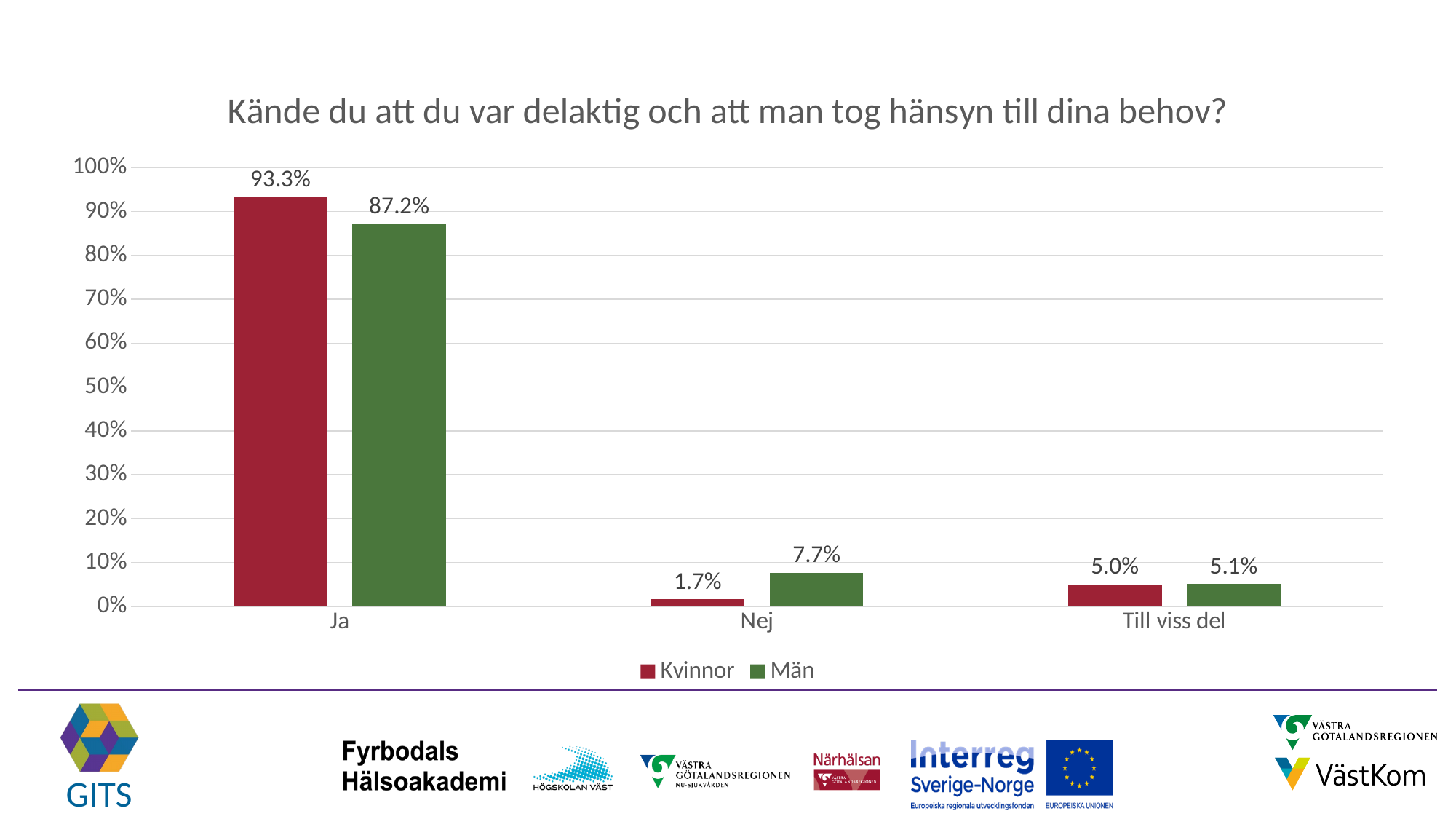
What is the value for Kvinnor in the Till viss del category? 5.0% What is the value for Män in the Nej category? 7.7% How many categories are shown on the x axis? 3 What kind of chart is shown on the slide? Bar chart What is the value for Kvinnor in the Ja category? 93.3% What is the difference between the Kvinnor and Män values in the Ja category? 6.1% Is the value for Män in the Ja category greater or less than 80%? greater In the Nej category, which series has the larger value, Kvinnor or Män? Män Which category has the lowest value for Kvinnor? Nej What colour are the bars for the Män series? Green Which category has the highest value for Män? Ja How many series does the legend list? 2